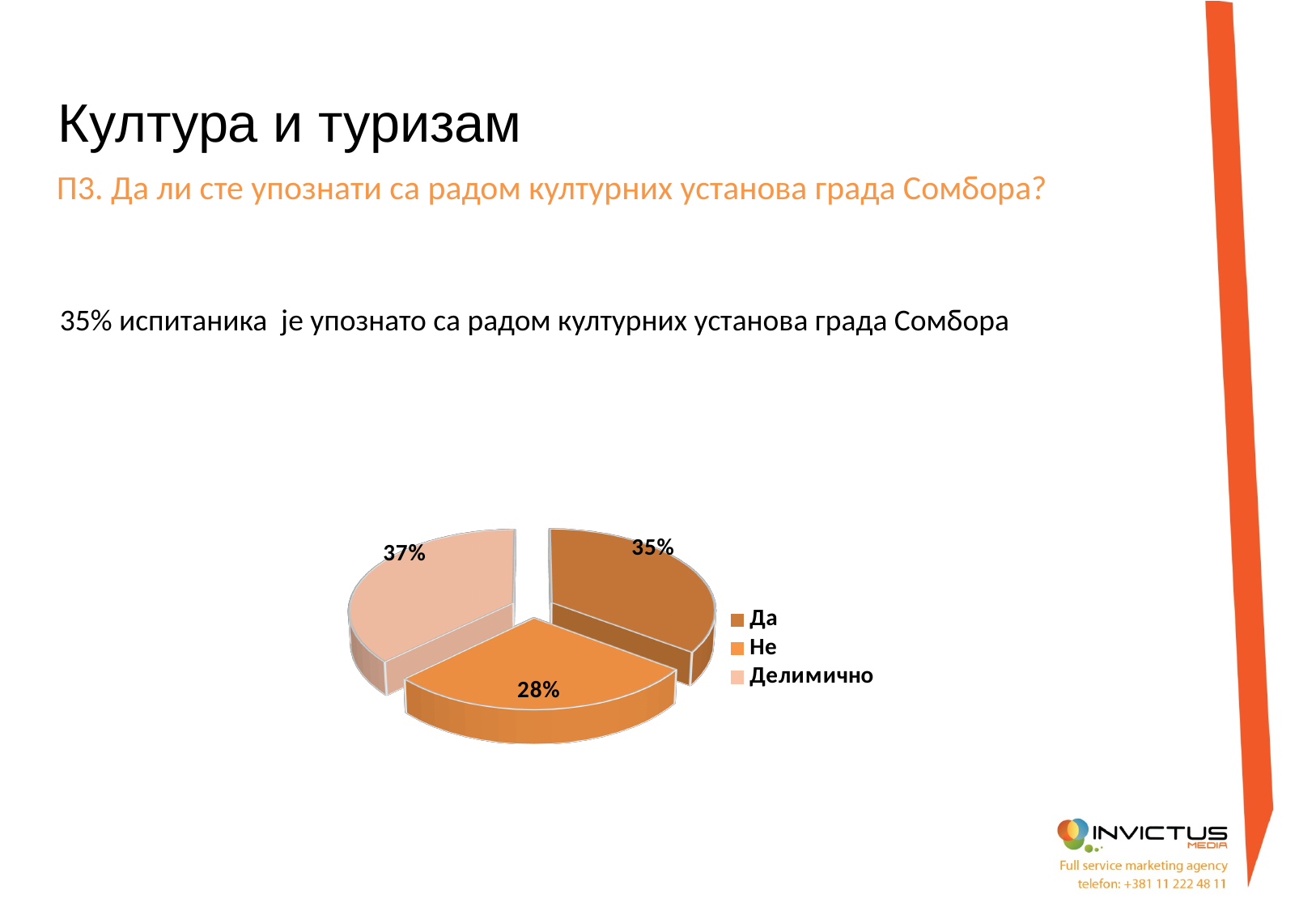
What percentage of respondents answered "Не"? 28% What percentage of respondents answered "Да"? 35% Which answer category has the largest share of the pie? Делимично What is the difference in percentage points between "Да" and "Не"? 7 How many entries does the legend list? 3 What is the difference in percentage points between "Делимично" and "Не"? 9 Which legend entry is shown in the lightest colour? Делимично How many slices does the pie chart have? 3 What kind of chart is shown on the slide? Pie chart What percentage of respondents answered "Делимично"? 37% Which is larger, the share for "Да" or the share for "Не"? Да Which answer category has the smallest share of the pie? Не